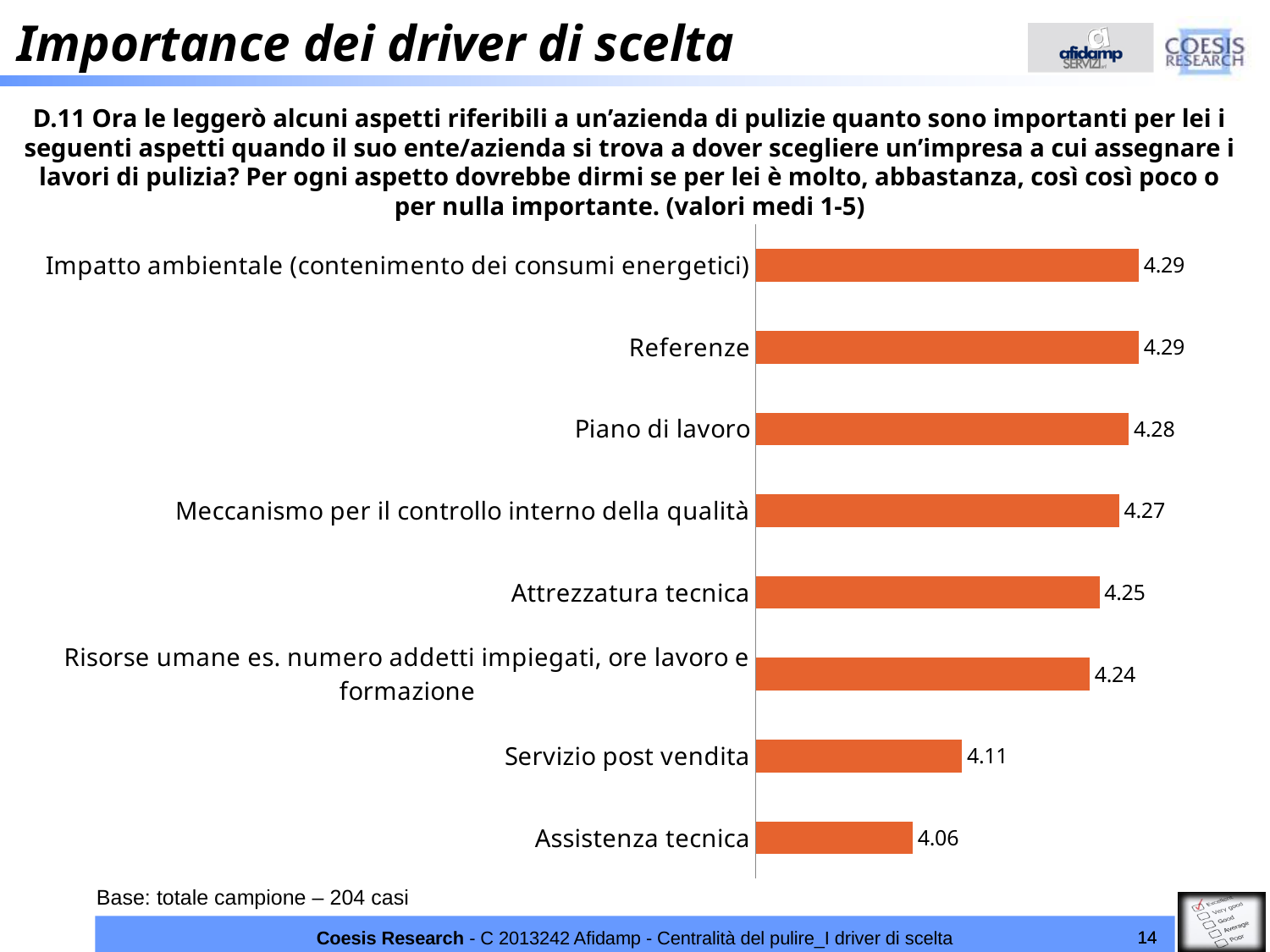
What kind of chart is shown on the slide? Bar chart Which category has the lowest value? Assistenza tecnica What colour are the bars in the chart? Orange How many categories are shown in the chart? 8 What is the difference between the value for Referenze and the value for Assistenza tecnica? 0.23 What is the difference between the value for Attrezzatura tecnica and the value for Servizio post vendita? 0.14 What is the value for Piano di lavoro? 4.28 What is the value for Attrezzatura tecnica? 4.25 Which is larger, the value for Piano di lavoro or the value for Risorse umane es. numero addetti impiegati, ore lavoro e formazione? Piano di lavoro What is the value for Meccanismo per il controllo interno della qualità? 4.27 Which is larger, the value for Servizio post vendita or the value for Assistenza tecnica? Servizio post vendita What is the value for Servizio post vendita? 4.11